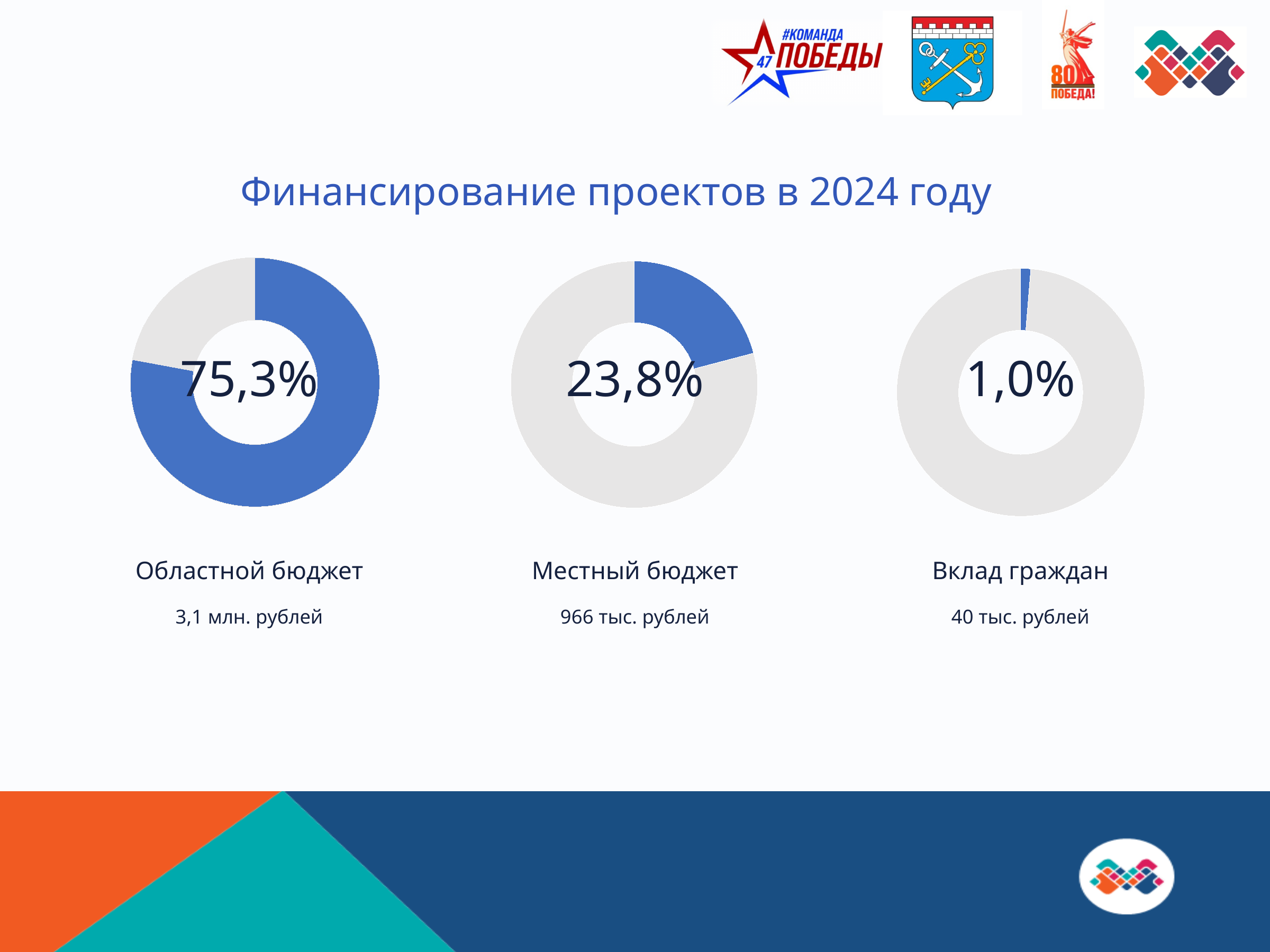
What amount in rubles is given under the «Вклад граждан» chart? 40 тыс. рублей What amount in rubles is given under the «Областной бюджет» chart? 3,1 млн. рублей What is the title of the slide above the charts? Финансирование проектов в 2024 году What is the difference in percentage points between the «Областной бюджет» share and the «Местный бюджет» share? 51,5% What percentage is shown in the donut chart labelled «Местный бюджет»? 23,8% What percentage is shown in the donut chart labelled «Областной бюджет»? 75,3% Which share is larger: «Местный бюджет» or «Вклад граждан»? Местный бюджет What kind of chart is used to show each funding share on the slide? Donut (pie) chart What percentage is shown in the donut chart labelled «Вклад граждан»? 1,0% Which funding source has the lowest share among the three donut charts? Вклад граждан Which funding source has the highest share among the three donut charts? Областной бюджет How many donut charts are shown on the slide? 3